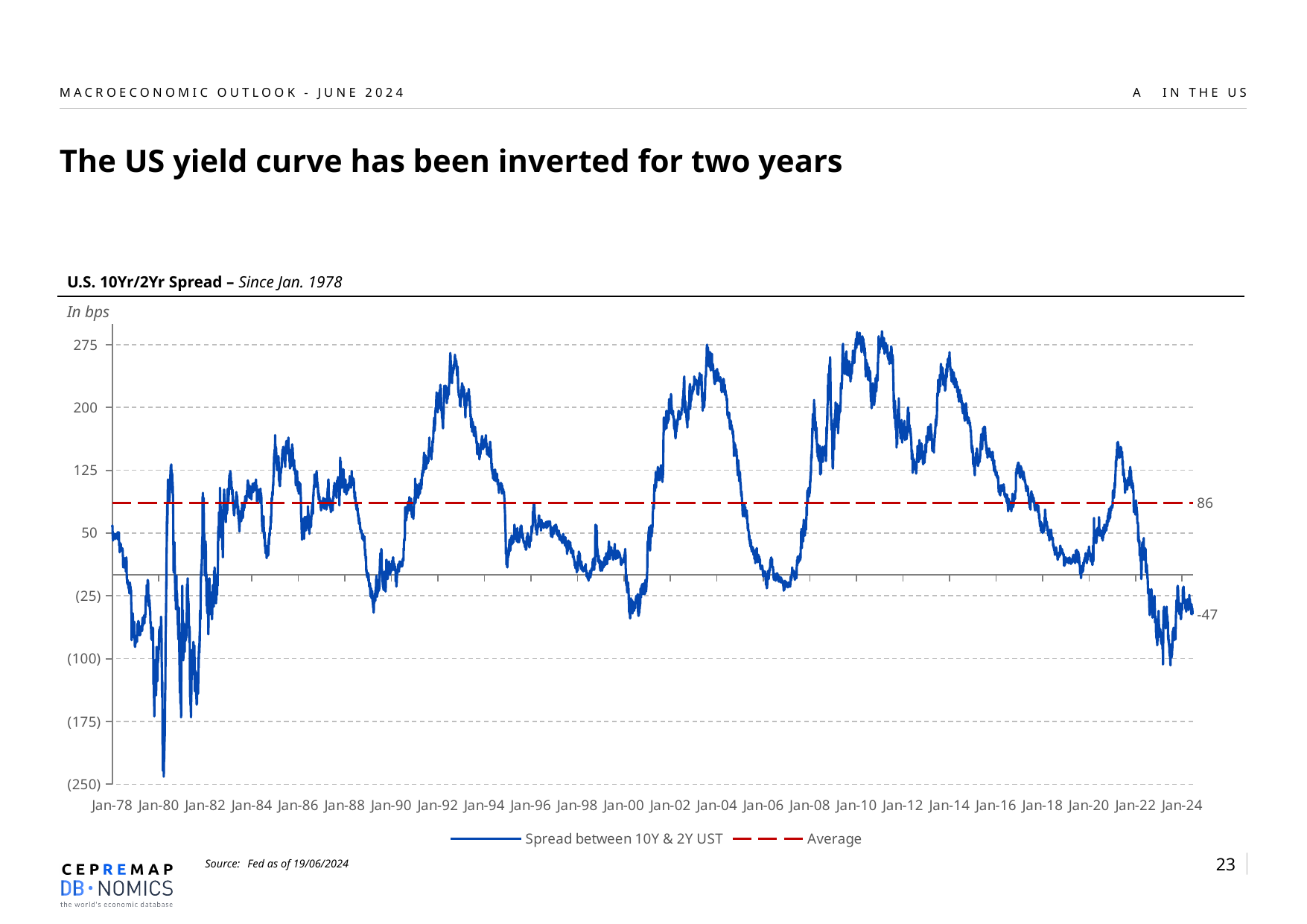
Which is larger, the Average value or the latest spread value? Average Is the spread value around Jan-04 greater or less than 200? greater What is the title of the chart? U.S. 10Yr/2Yr Spread – Since Jan. 1978 What is the latest value of the spread between 10Y & 2Y UST shown at the end of the line? -47 In what unit are the values on the chart expressed? In bps Is the spread value around Jan-10 greater or less than 200? greater What is the value of the Average line shown on the chart? 86 Between Jan-22 and Jan-24, does the spread rise or fall? fall How many series does the legend list? 2 What kind of chart is shown on the slide? line chart What is the difference between the Average (86) and the latest spread value (-47)? 133 Is the lowest spread value around 1980 greater or less than (175)? less